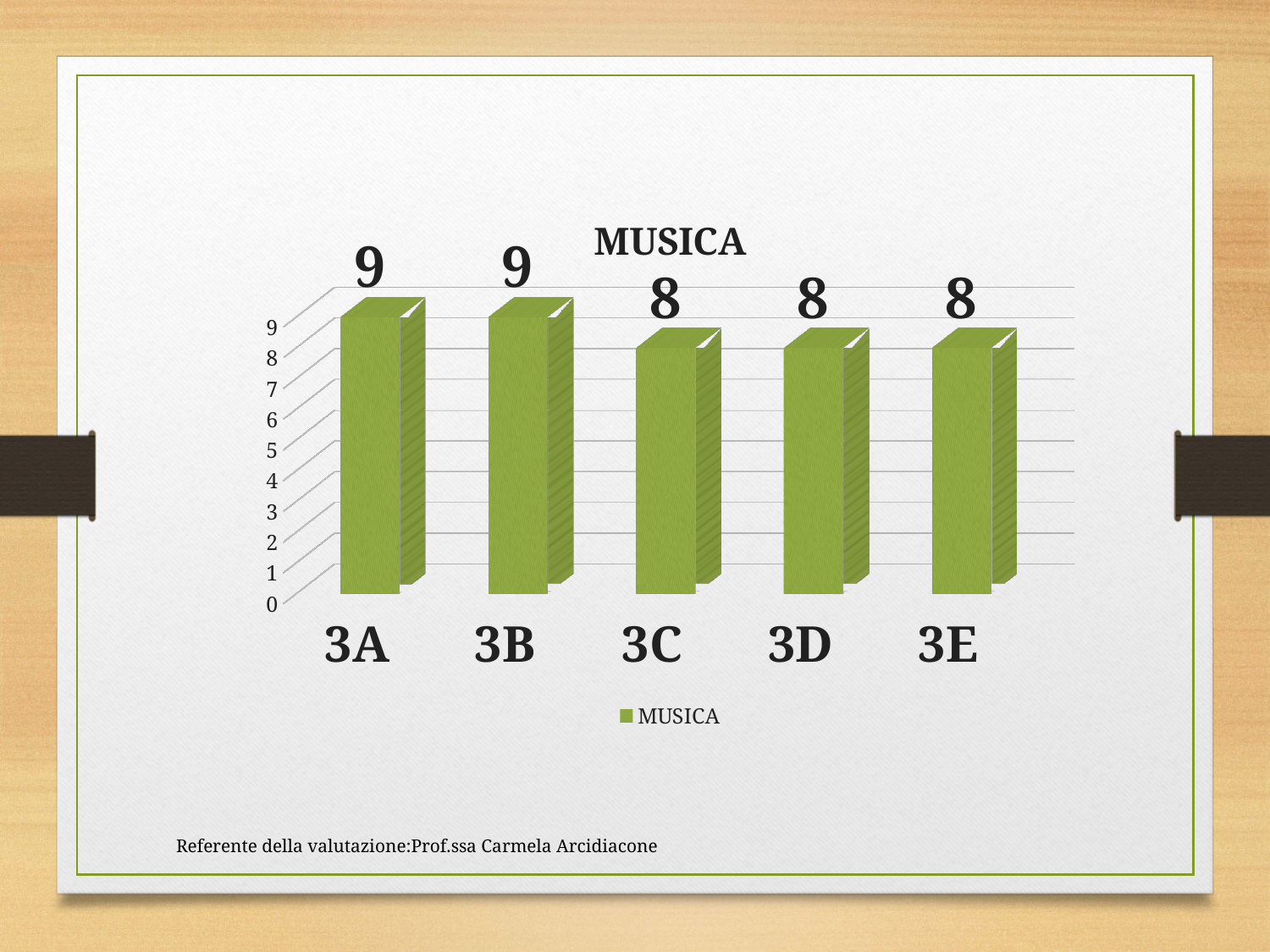
Do the values rise or fall from 3A to 3E along the x axis? fall What is the value for 3A in the MUSICA chart? 9 What is the value for 3E in the MUSICA chart? 8 How many categories are shown on the x axis of the chart? 5 Is the value for 3B greater or less than 5? greater What is the title of the chart? MUSICA What is the difference between the values for 3B and 3D? 1 Which is larger, the value for 3A or the value for 3C? 3A What is the value for 3C in the MUSICA chart? 8 What is the value for 3D in the MUSICA chart? 8 What kind of chart is shown on the slide? bar chart How many series does the legend list? 1